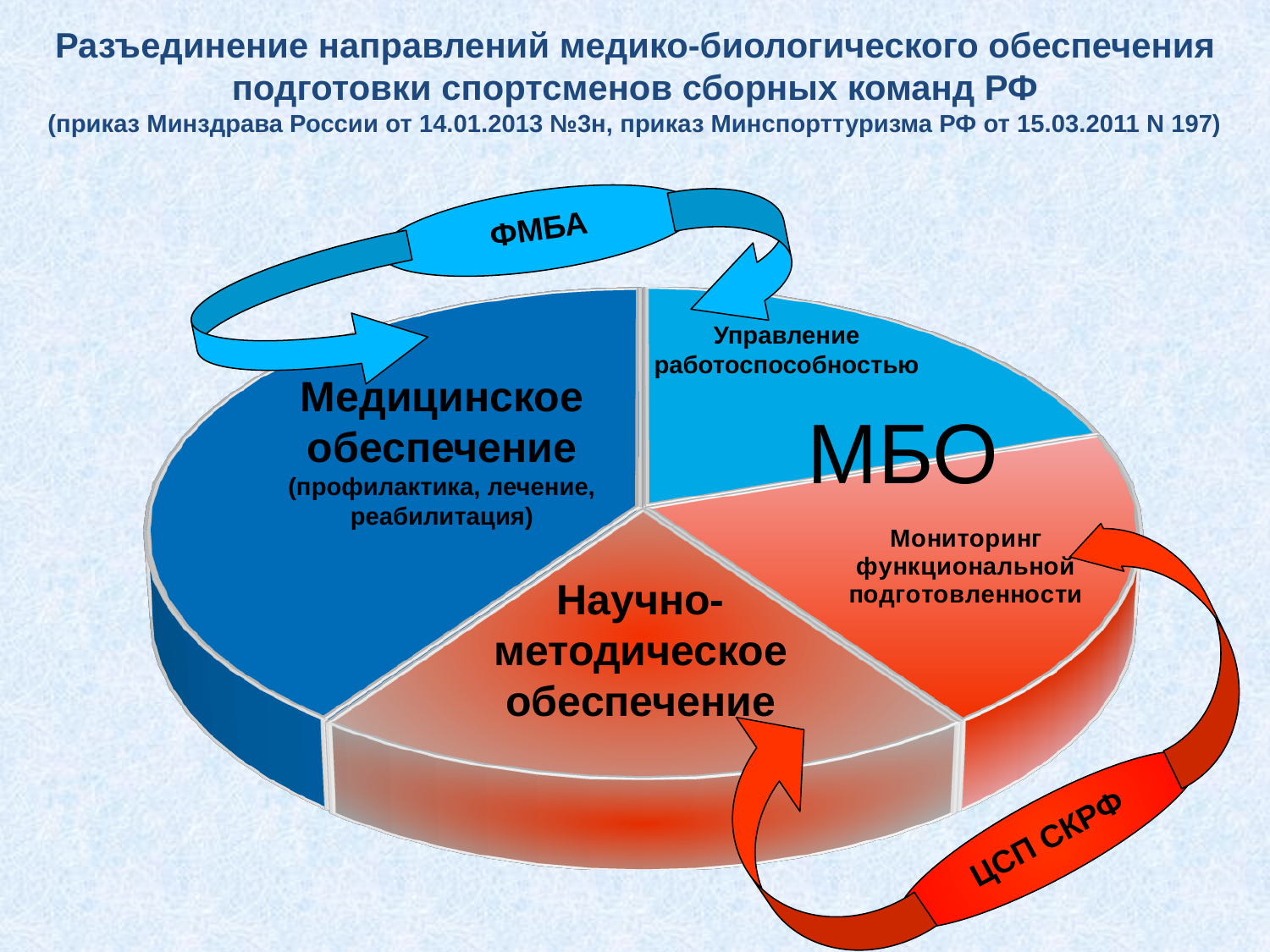
Which slice of the pie chart is the largest? Медицинское обеспечение What colour is the slice labelled Медицинское обеспечение? dark blue Which of the two slices is larger: Медицинское обеспечение or Управление работоспособностью? Медицинское обеспечение What label is printed in large letters in the centre-right of the pie chart? МБО What kind of chart is shown on the slide? pie chart How many slices does the pie chart have? 4